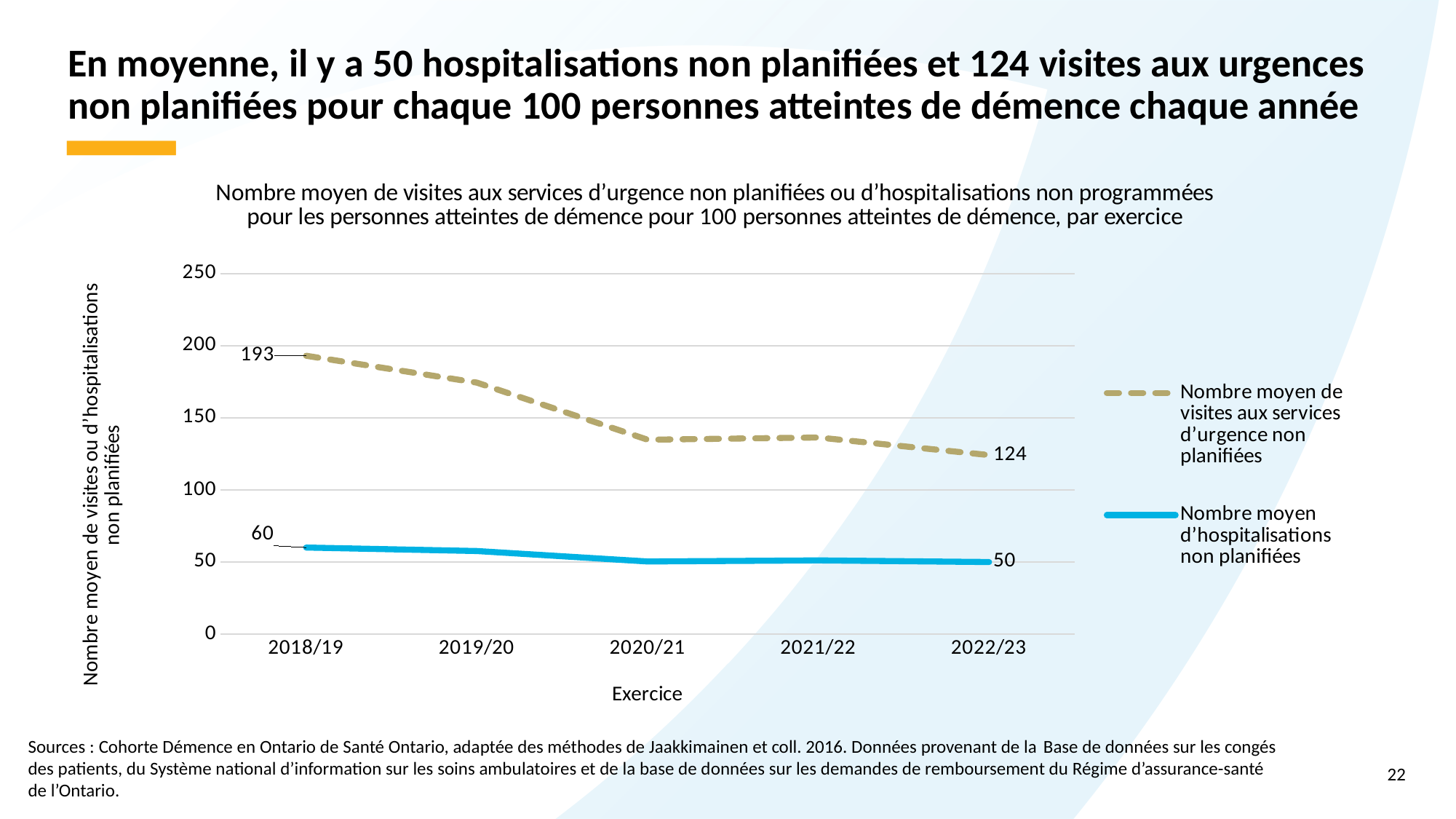
Is the value for unplanned emergency department visits in 2020/21 greater or less than 150? less How many fiscal years (exercices) are plotted on the x axis? 5 Do the values for unplanned emergency department visits rise or fall from 2018/19 to 2022/23? fall Which series has the higher value in 2022/23: unplanned emergency department visits or unplanned hospitalisations? Nombre moyen de visites aux services d'urgence non planifiées How many series does the legend list? 2 What is the value for 'Nombre moyen d'hospitalisations non planifiées' in 2018/19? 60 By how much did the average number of unplanned emergency department visits fall between 2018/19 and 2022/23? 69 What is the value for 'Nombre moyen de visites aux services d'urgence non planifiées' in 2018/19? 193 What is the value for 'Nombre moyen d'hospitalisations non planifiées' in 2022/23? 50 By how much did the average number of unplanned hospitalisations fall between 2018/19 and 2022/23? 10 What is the value for 'Nombre moyen de visites aux services d'urgence non planifiées' in 2022/23? 124 What type of chart is shown on the slide? line chart